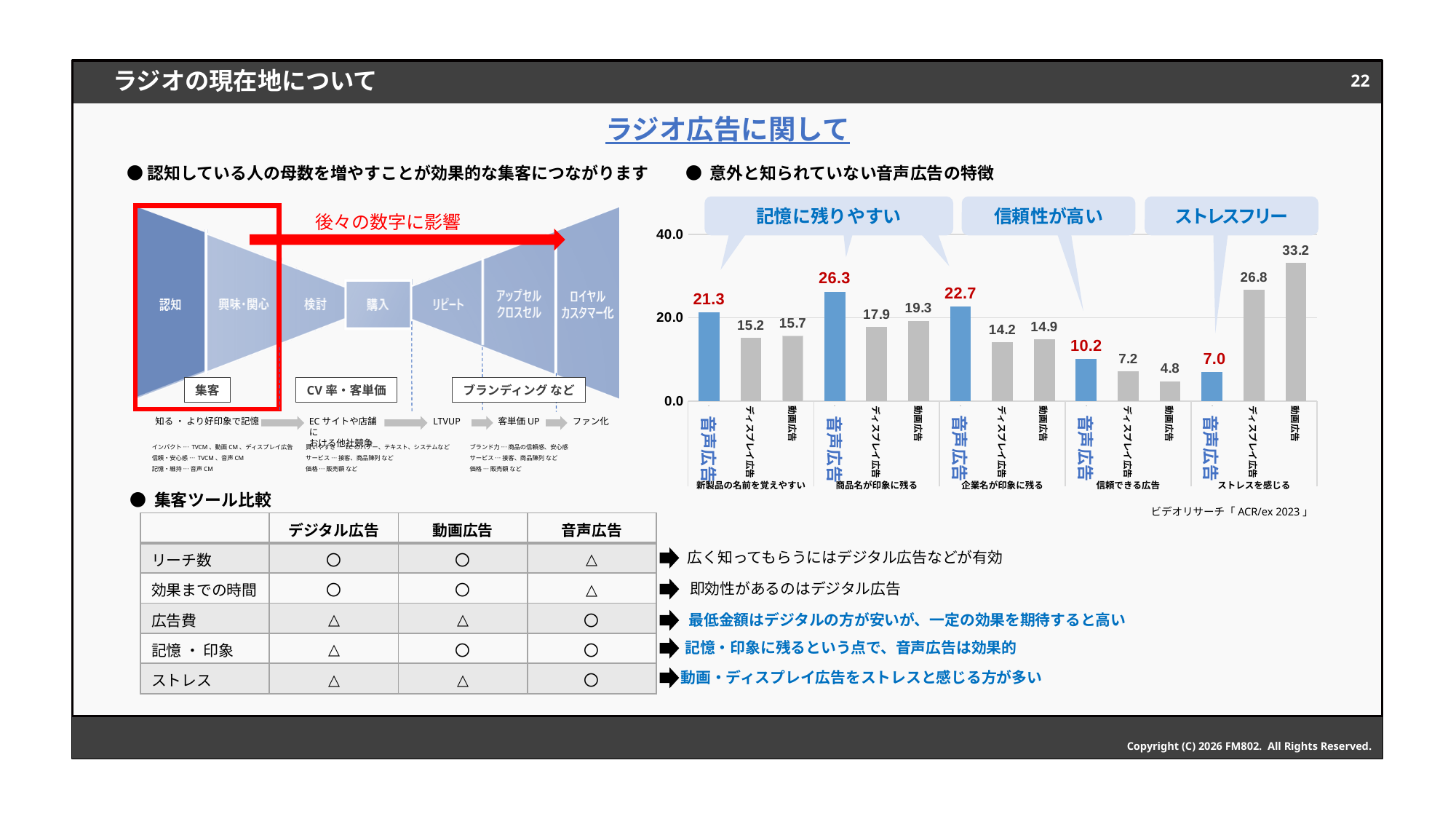
In the bar chart on the right, which is larger in the 信頼できる広告 group: 音声広告 or 動画広告? 音声広告 In the bar chart on the right, is the value for 動画広告 in the 商品名が印象に残る group greater or less than 20.0? less In the bar chart on the right, what is the value for 音声広告 in the 新製品の名前を覚えやすい group? 21.3 In the bar chart on the right, which ad type has the highest value in the 商品名が印象に残る group? 音声広告 In the bar chart on the right, what is the difference between 動画広告 and 音声広告 in the ストレスを感じる group? 26.2 What is the data source cited below the bar chart on the right? ビデオリサーチ「ACR/ex 2023」 In the bar chart on the right, what is the difference between 音声広告 and ディスプレイ広告 in the 企業名が印象に残る group? 8.5 In the bar chart on the right, which ad type has the lowest value in the ストレスを感じる group? 音声広告 How many category groups are shown along the x axis of the bar chart on the right? 5 What kind of chart is shown on the right side of the slide? bar chart In the bar chart on the right, what is the value for ディスプレイ広告 in the 信頼できる広告 group? 7.2 In the bar chart on the right, what is the value for 動画広告 in the ストレスを感じる group? 33.2